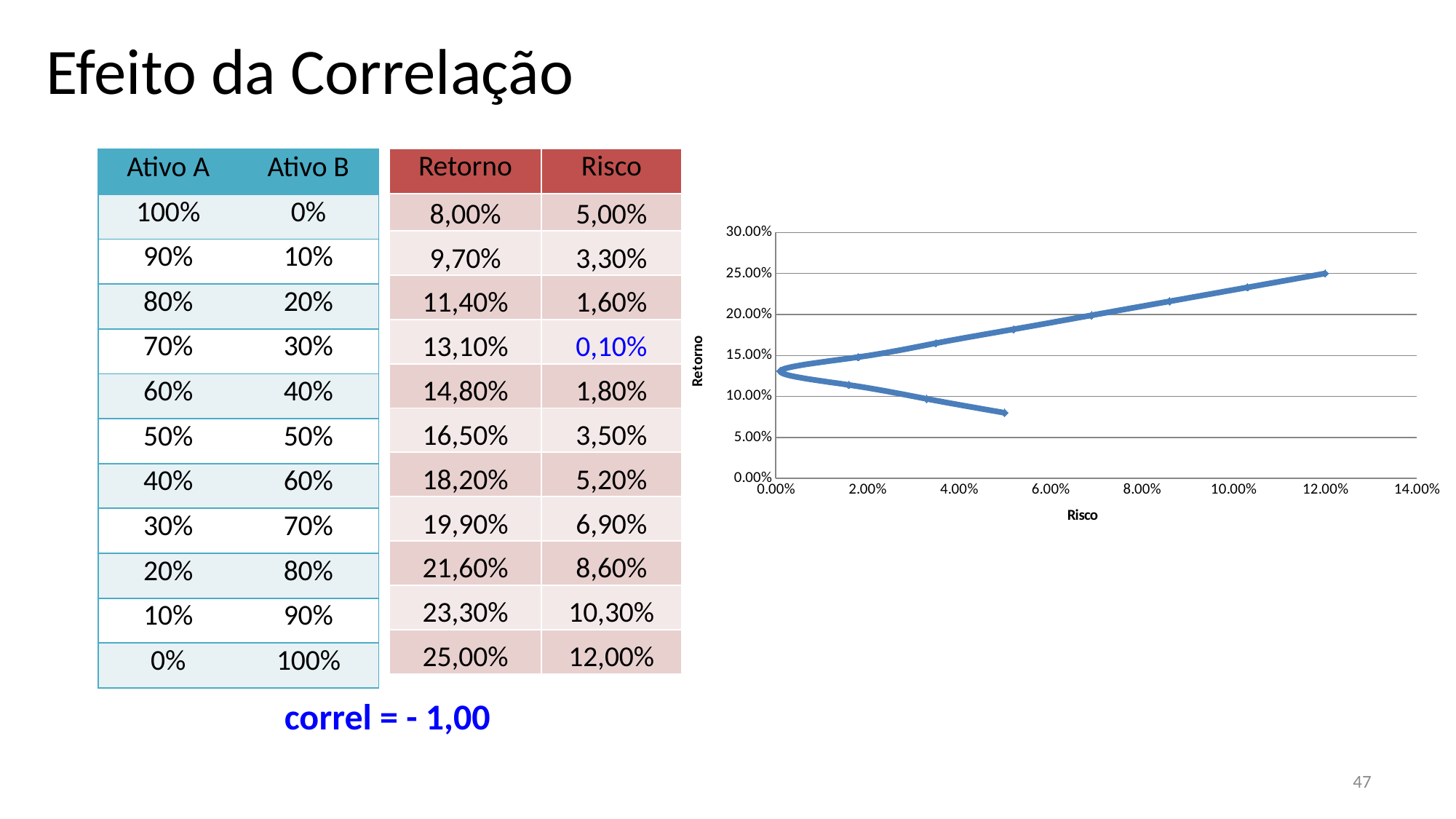
Is the largest Risco value on the chart greater or less than 10.00%? greater What is the highest Retorno value plotted on the chart? 25,00% What is the title of the horizontal axis of the chart? Risco What is the lowest Risco value among the plotted points? 0,10% What is the difference between the highest and lowest Retorno values plotted? 17,00% What kind of chart is shown on the right of the slide? scatter chart with lines Which point has the higher Retorno: the rightmost point of the chart or the lowest point of the chart? the rightmost point Along the upper branch of the curve, does Retorno rise or fall as Risco increases? rises How many data points are plotted on the chart? 11 What is the title of the vertical axis of the chart? Retorno Is the highest Retorno value on the chart greater or less than 20.00%? greater What is the Retorno value at the point where Risco is 12,00%? 25,00%